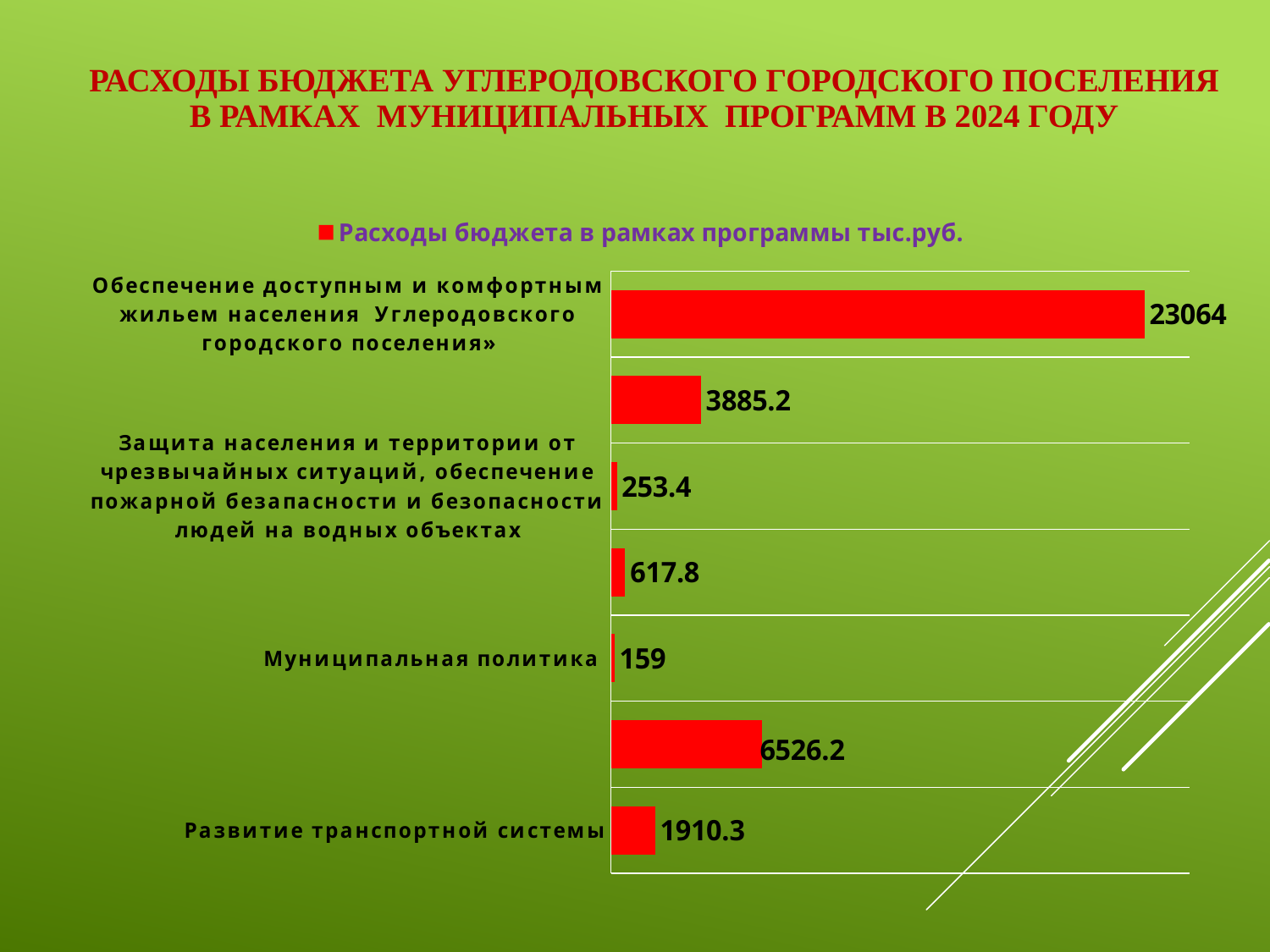
Which category has the highest value? Обеспечение доступным и комфортным жильем населения Углеродовского городского поселения» What kind of chart is shown on the slide? Bar chart How many bars are plotted in the chart? 7 What is the difference between the values for «Развитие транспортной системы» and «Муниципальная политика»? 1751.3 What is the value for «Развитие транспортной системы»? 1910.3 What is the value for «Муниципальная политика»? 159 What is the difference between the values for «Защита населения и территории от чрезвычайных ситуаций...» and «Муниципальная политика»? 94.4 What is the value for «Обеспечение доступным и комфортным жильем населения Углеродовского городского поселения»? 23064 How many series does the legend list? 1 What is the value for «Защита населения и территории от чрезвычайных ситуаций, обеспечение пожарной безапасности и безопасности людей на водных объектах»? 253.4 Which category has the lowest value? Муниципальная политика Which is larger: the value for «Развитие транспортной системы» or for «Муниципальная политика»? Развитие транспортной системы